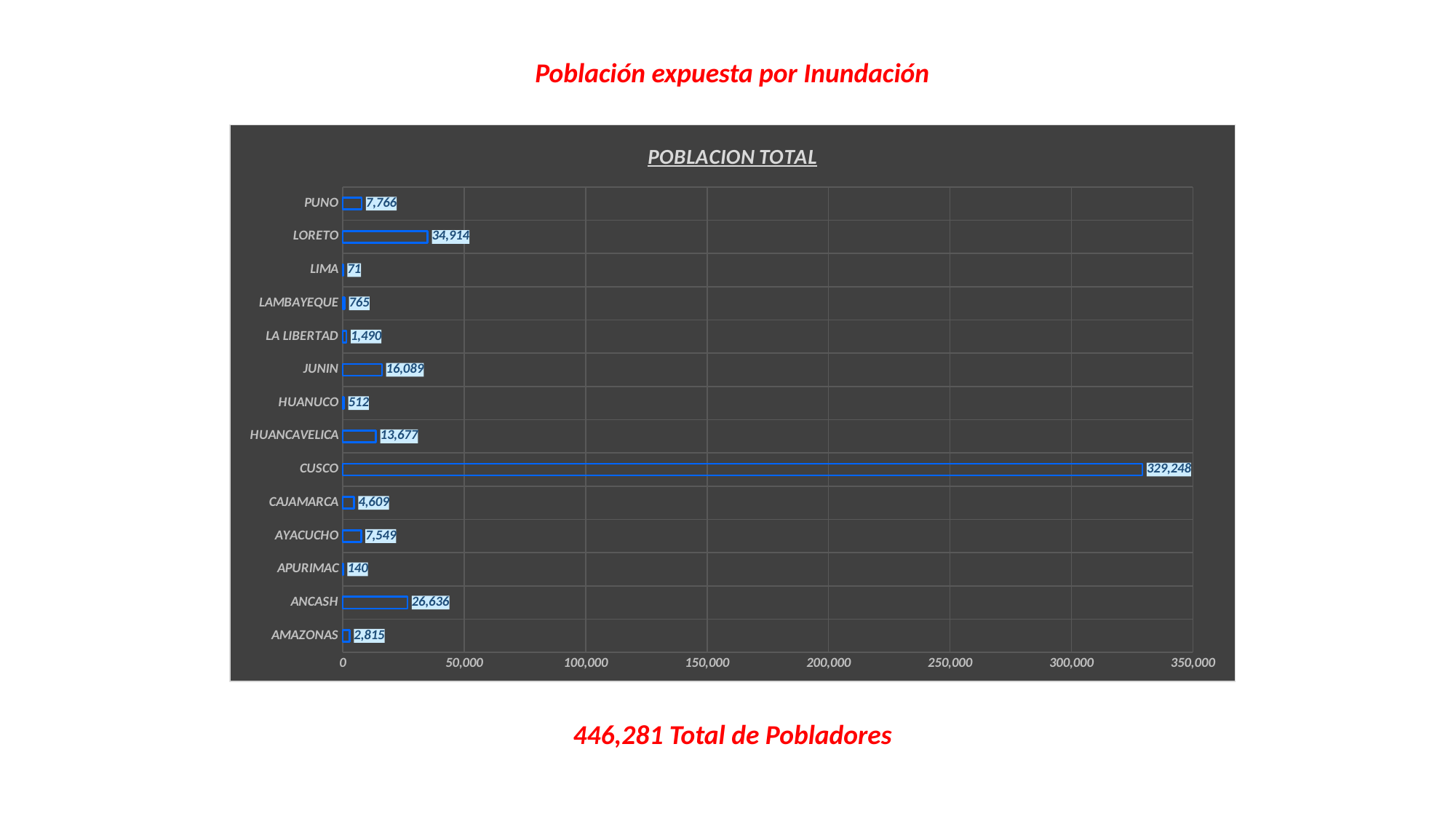
Which is larger, the value for PUNO or the value for AYACUCHO? PUNO What kind of chart is shown? bar chart Which category has the highest value? CUSCO What is the difference between the values for LORETO and ANCASH? 8,278 What is the value for HUANCAVELICA? 13,677 What is the value for CUSCO? 329,248 Is the value for CUSCO greater or less than 300,000? greater Which category has the lowest value? LIMA What is the value for AMAZONAS? 2,815 What is the value for LORETO? 34,914 How many categories are shown in the chart? 14 What is the title of the chart? POBLACION TOTAL